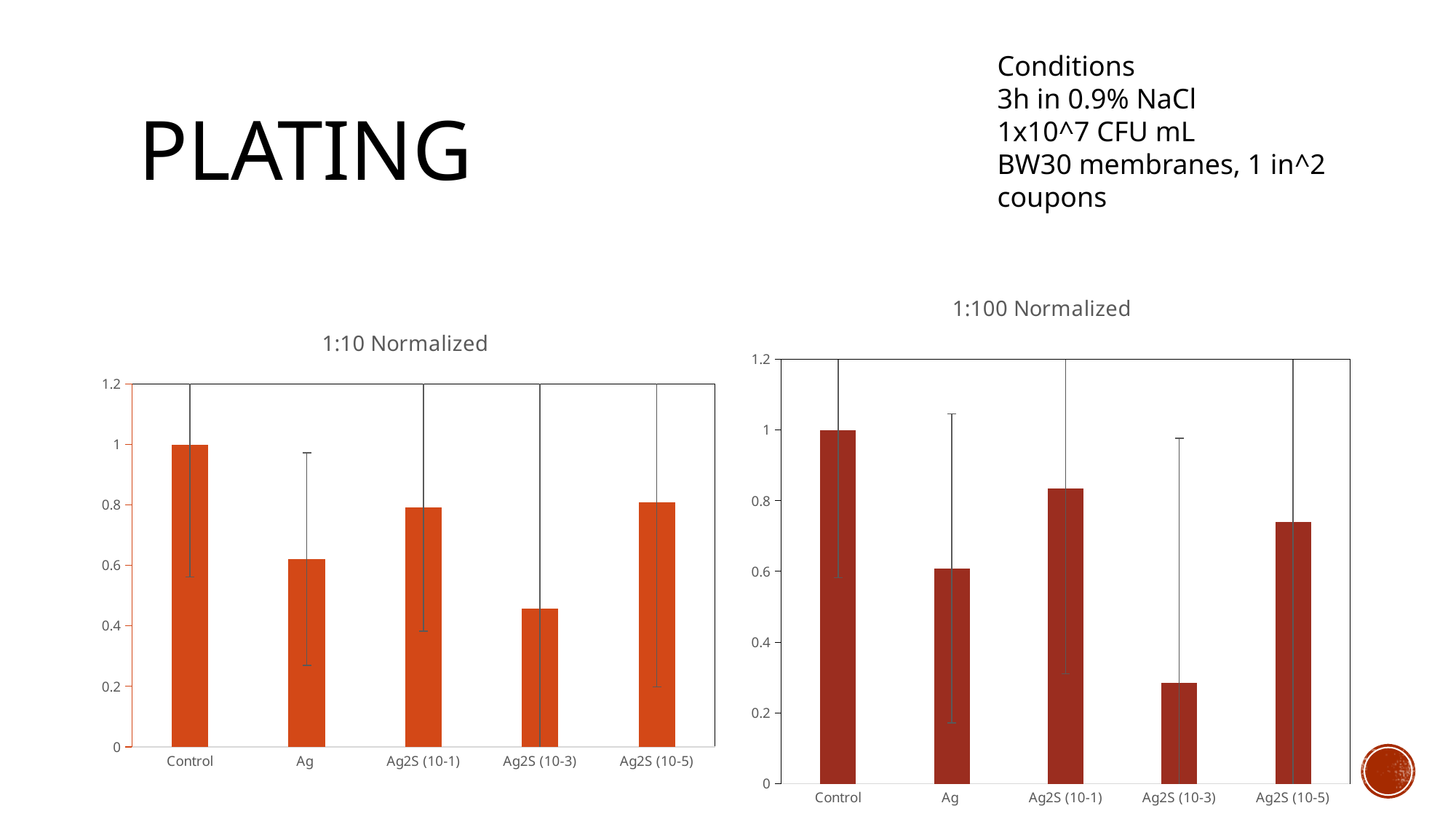
In the 1:10 Normalized chart, which category has the lowest value? Ag2S (10-3) In the 1:100 Normalized chart, is the value for Ag2S (10-1) greater or less than 0.8? greater In the 1:100 Normalized chart, which is larger, the value for Ag2S (10-1) or the value for Ag2S (10-5)? Ag2S (10-1) How many categories are shown in the 1:10 Normalized chart? 5 In the 1:10 Normalized chart, which is larger, the value for Ag or the value for Ag2S (10-3)? Ag In the 1:100 Normalized chart, what is the value for Control? 1 In the 1:100 Normalized chart, which category has the highest value? Control In the 1:10 Normalized chart, is the value for Ag greater or less than 0.8? less In the 1:100 Normalized chart, is the value for Ag2S (10-3) greater or less than 0.4? less In the 1:100 Normalized chart, which category has the lowest value? Ag2S (10-3) In the 1:10 Normalized chart, what is the value for Control? 1 What kind of chart is the 1:100 Normalized chart? bar chart